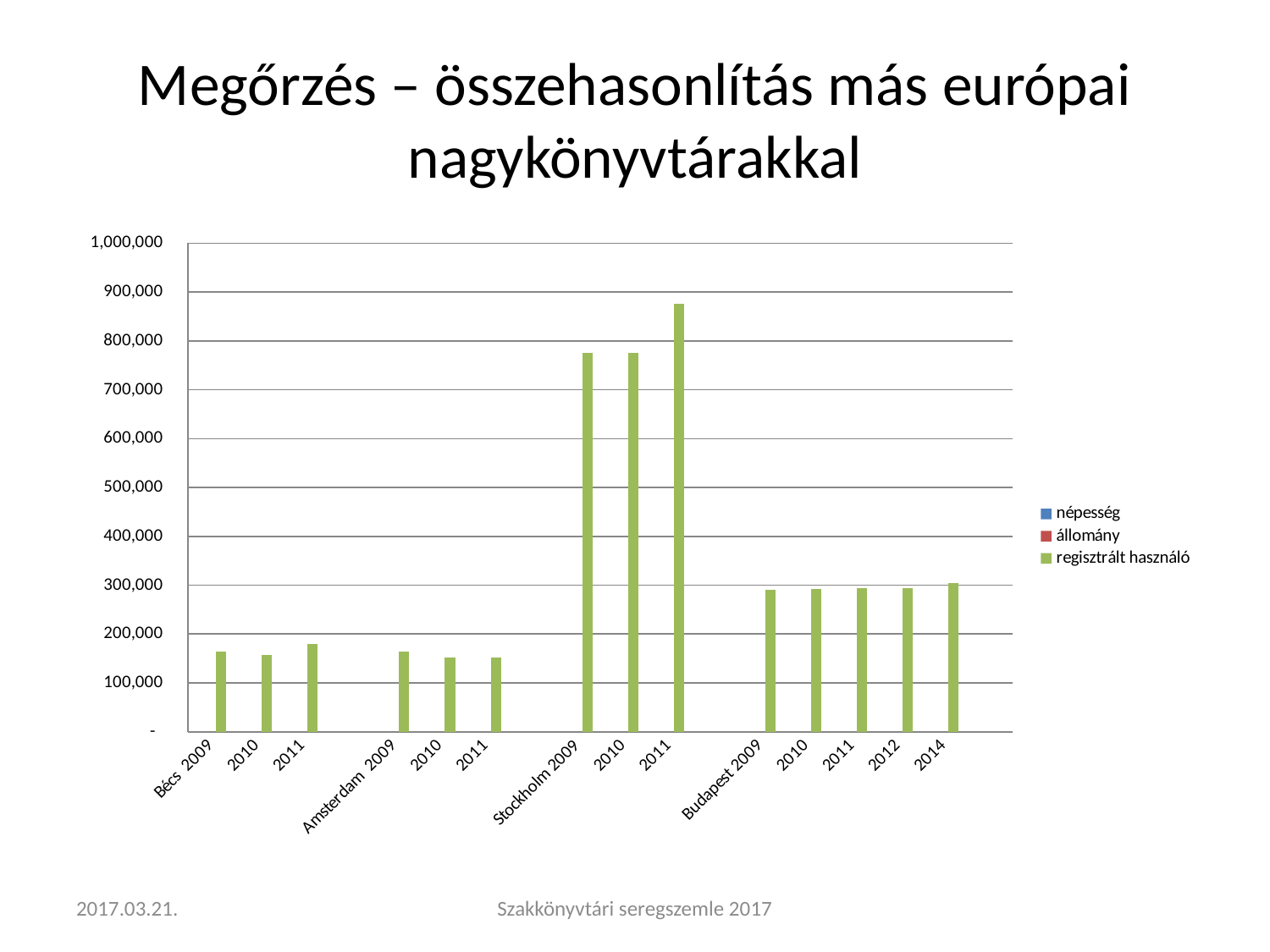
Is the value for Stockholm 2011 greater or less than 800,000? greater Which is larger, the value for Stockholm 2011 or the value for Stockholm 2009? Stockholm 2011 Which category has the highest bar? Stockholm 2011 Which series is shown in green in the legend? regisztrált használó Which is larger, the value for Budapest 2011 or the value for Bécs 2011? Budapest 2011 Is the value for Bécs 2011 greater or less than 200,000? less Is the value for Stockholm 2009 greater or less than 700,000? greater How many series does the legend list? 3 How many categories are shown along the x axis? 14 What kind of chart is shown on the slide? bar chart